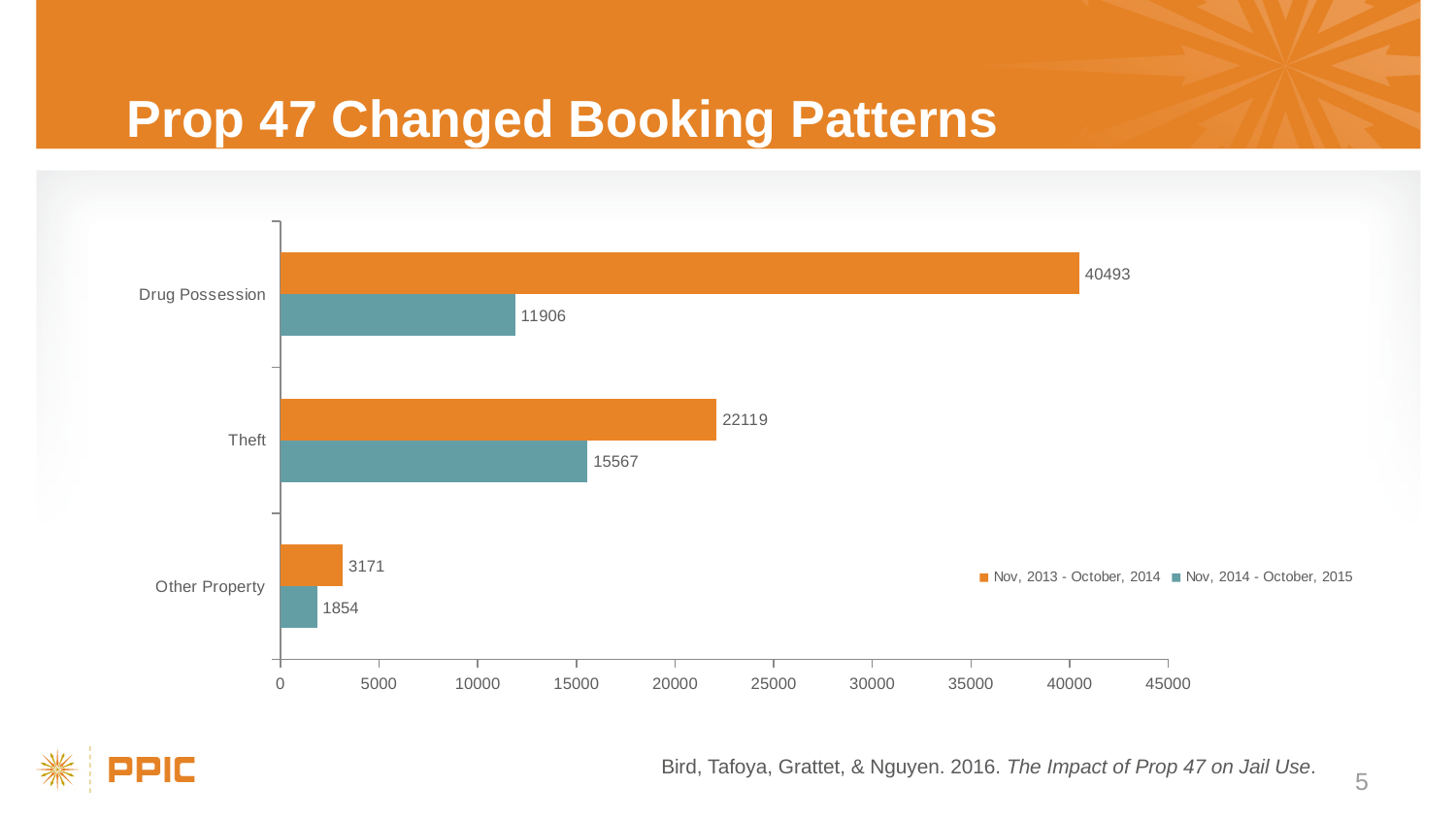
What is the value for Other Property in the Nov, 2013 - October, 2014 series? 3171 How many series does the legend list? 2 What is the value for Drug Possession in the Nov, 2013 - October, 2014 series? 40493 What is the difference between the Nov, 2013 - October, 2014 and Nov, 2014 - October, 2015 values for Drug Possession? 28587 Is the Nov, 2013 - October, 2014 value for Theft greater or less than 20000? greater Which category has the lowest value in the Nov, 2014 - October, 2015 series? Other Property Which category has the highest value in the Nov, 2013 - October, 2014 series? Drug Possession Which is larger: the Nov, 2014 - October, 2015 value for Drug Possession or the Nov, 2014 - October, 2015 value for Theft? Theft What is the value for Theft in the Nov, 2014 - October, 2015 series? 15567 How many categories are shown on the chart? 3 What kind of chart is shown on the slide? Bar chart What is the difference between the Nov, 2013 - October, 2014 and Nov, 2014 - October, 2015 values for Theft? 6552